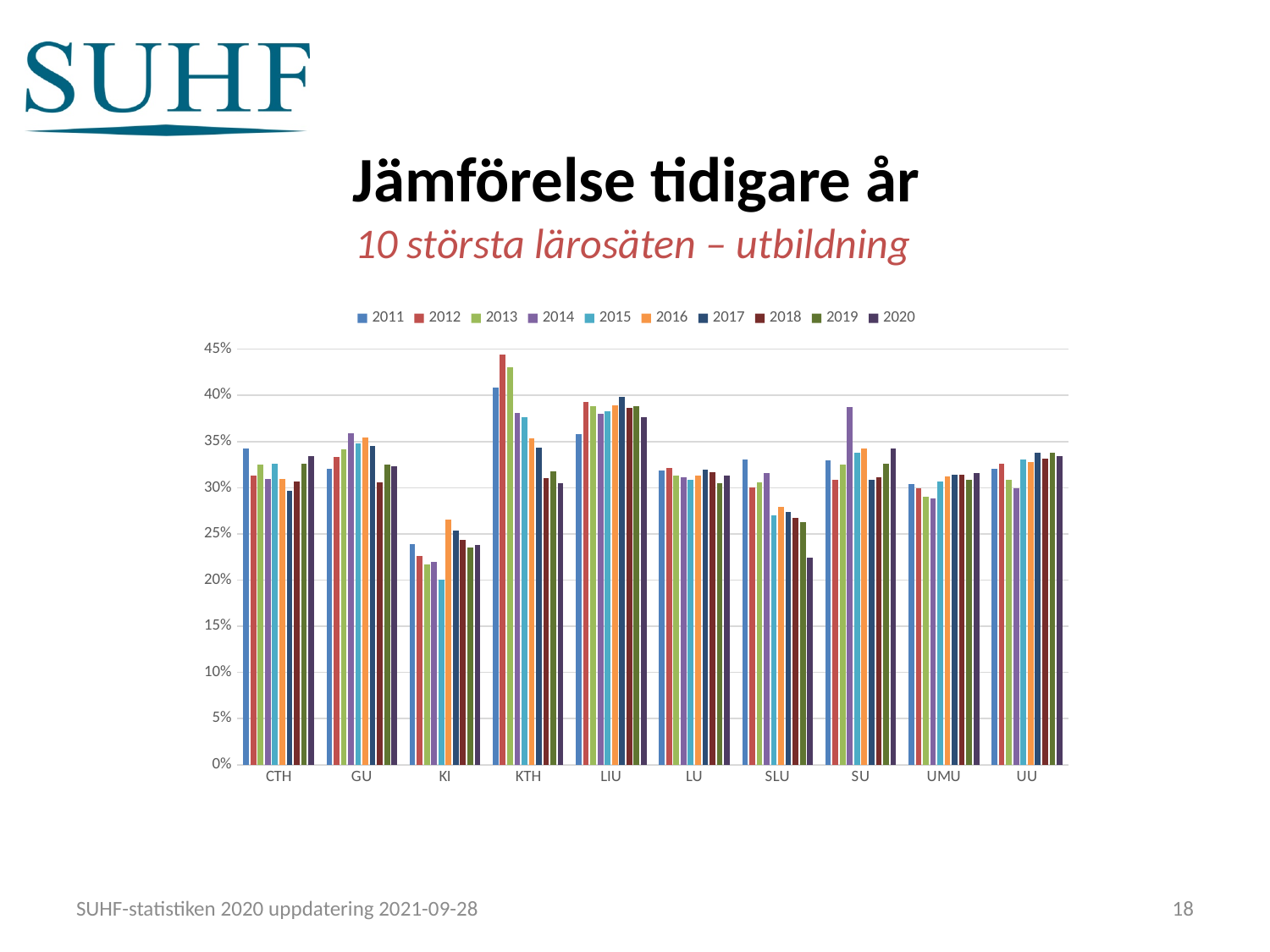
How many institutions (categories) are shown on the x axis? 10 Which institution has the single shortest bar in the chart? KI For KI, which is larger: the 2016 value or the 2015 value? 2016 For KTH, do the values generally rise or fall from 2011 to 2020? fall What kind of chart is shown on the slide? bar chart Which institution has the single tallest bar in the chart? KTH Is the 2020 value for SLU greater or less than 25%? less Is the 2012 value for KTH greater or less than 40%? greater Is the 2014 value for SU greater or less than 35%? greater Which year is the first entry in the legend? 2011 How many series does the legend list? 10